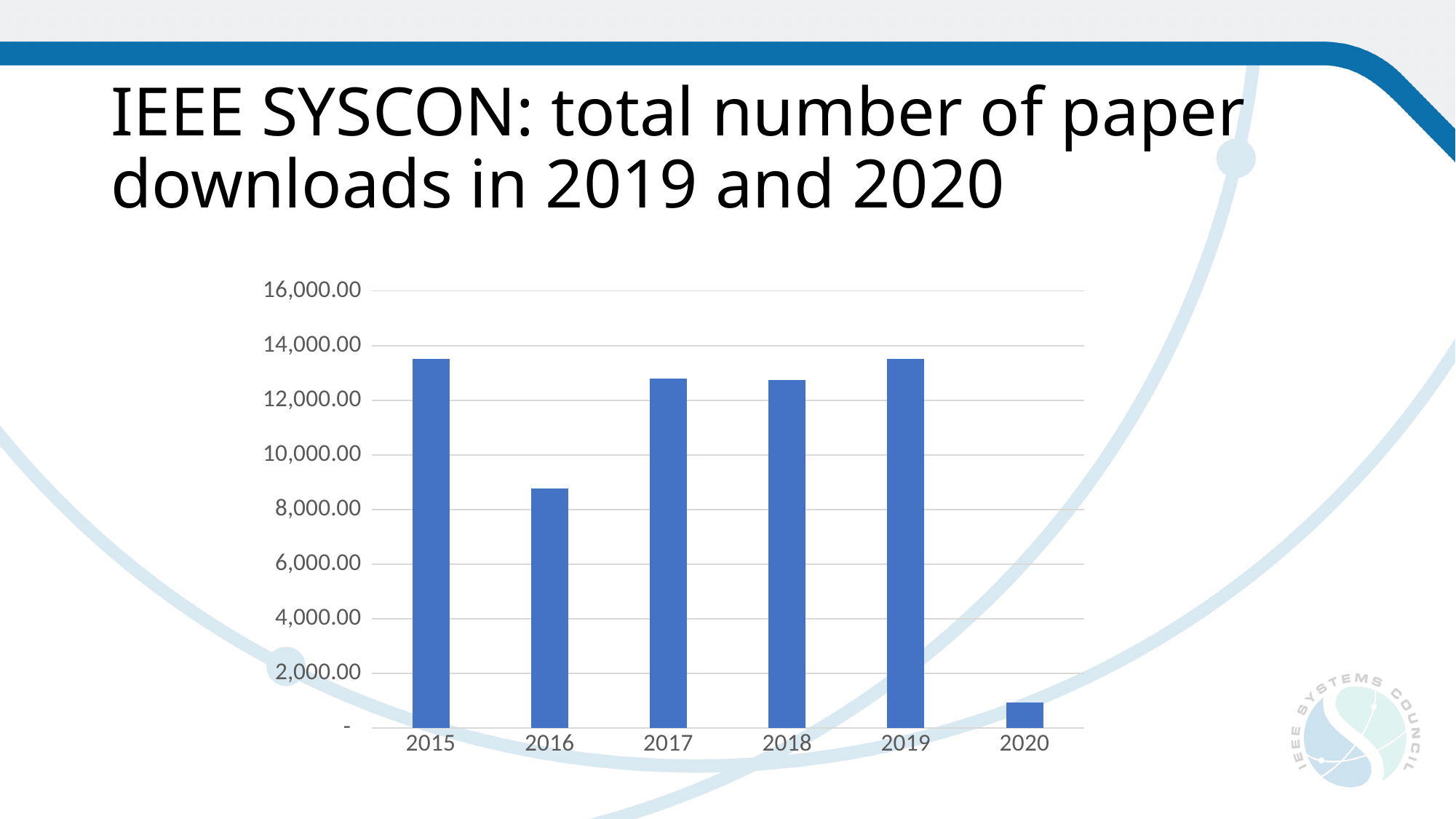
Is the value for 2020 greater or less than 2,000? less What is the title of the slide containing the chart? IEEE SYSCON: total number of paper downloads in 2019 and 2020 Is the value for 2016 greater or less than 8,000? greater How many years are shown on the x axis of the chart? 6 Is the value for 2017 greater or less than 12,000? greater What kind of chart is shown on the slide? bar chart Which year has the larger value, 2016 or 2017? 2017 Which year has the larger value, 2019 or 2020? 2019 Which year has the lowest number of paper downloads? 2020 Do the values rise or fall from 2019 to 2020? fall